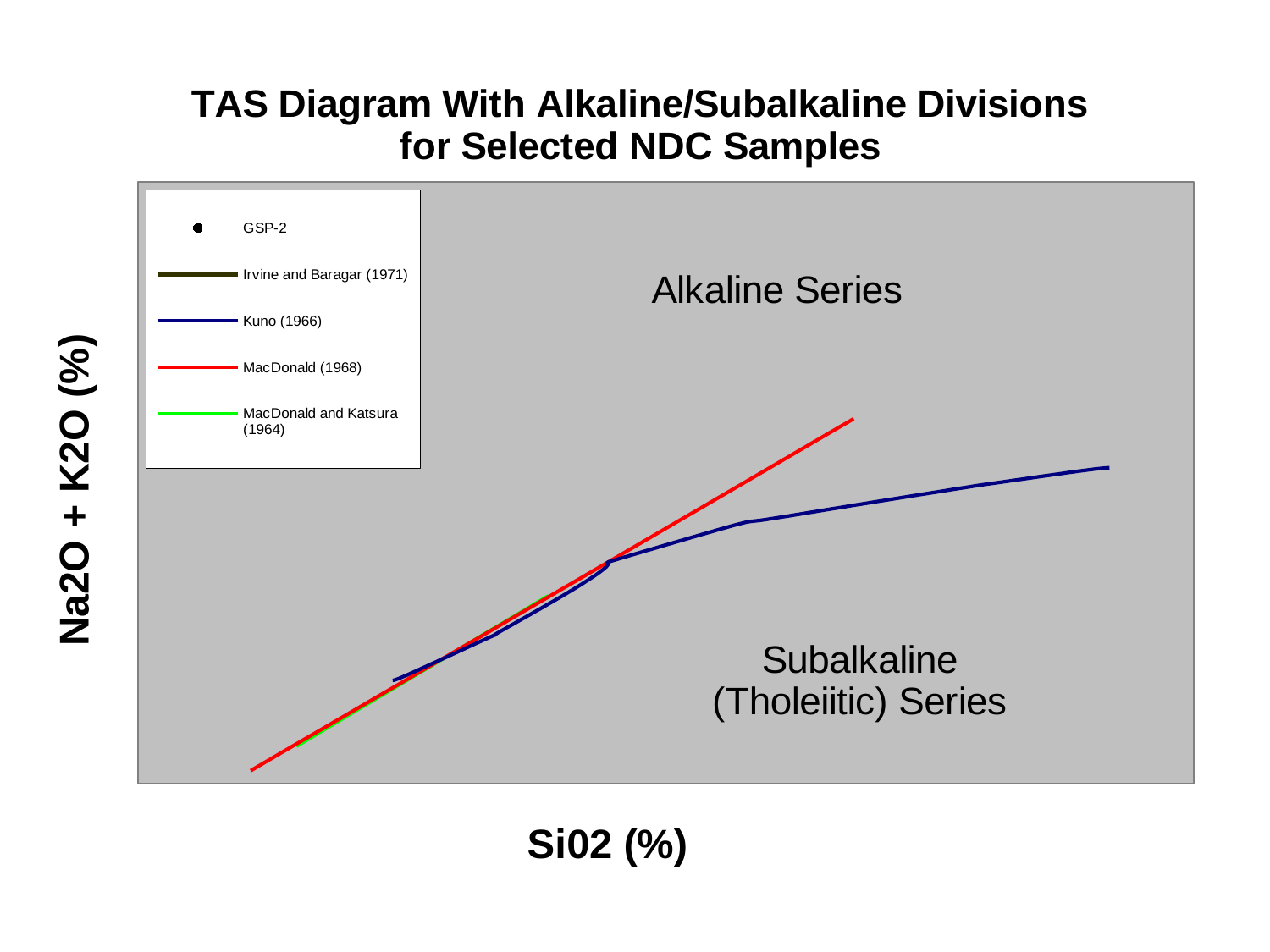
How many entries does the legend list? 5 Do the plotted lines rise or fall as Si02 (%) increases along the x axis? rise What kind of chart is shown on the slide? line chart Which legend series is drawn as a red line? MacDonald (1968) What is the title of the chart? TAS Diagram With Alkaline/Subalkaline Divisions for Selected NDC Samples